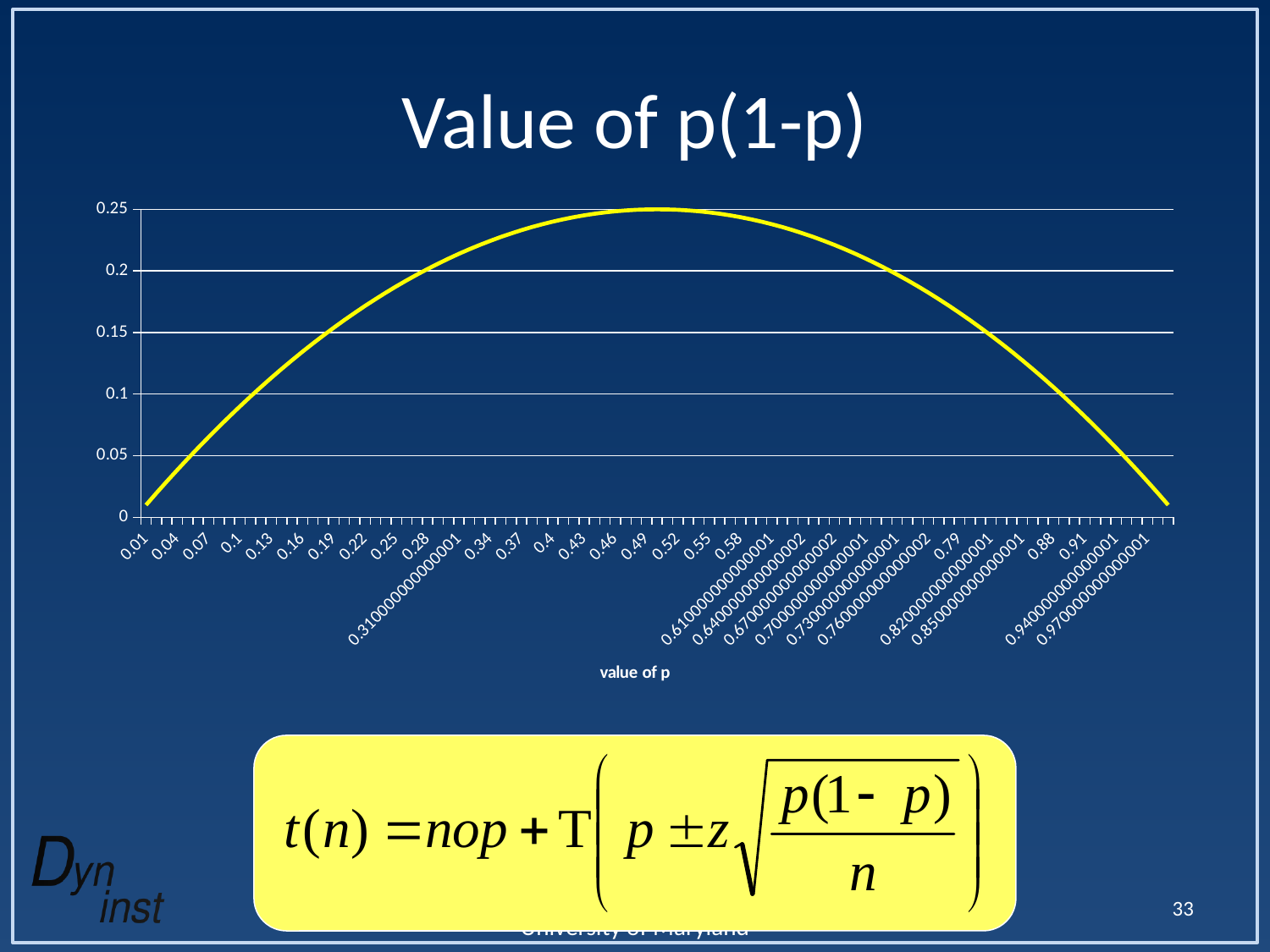
What is the title of the chart? Value of p(1-p) How does the curve behave as p increases from 0.01 to 0.97? rises to a peak near the middle, then falls Is the value for p = 0.25 greater or less than 0.15? greater What kind of chart is shown on the slide? line chart Which has the larger value, p = 0.25 or p = 0.1? p = 0.25 Is the value for p = 0.16 greater or less than 0.15? less Is the value for p = 0.4 greater or less than 0.2? greater What is the highest value the curve reaches on the y axis? 0.25 What is the label on the x axis of the chart? value of p